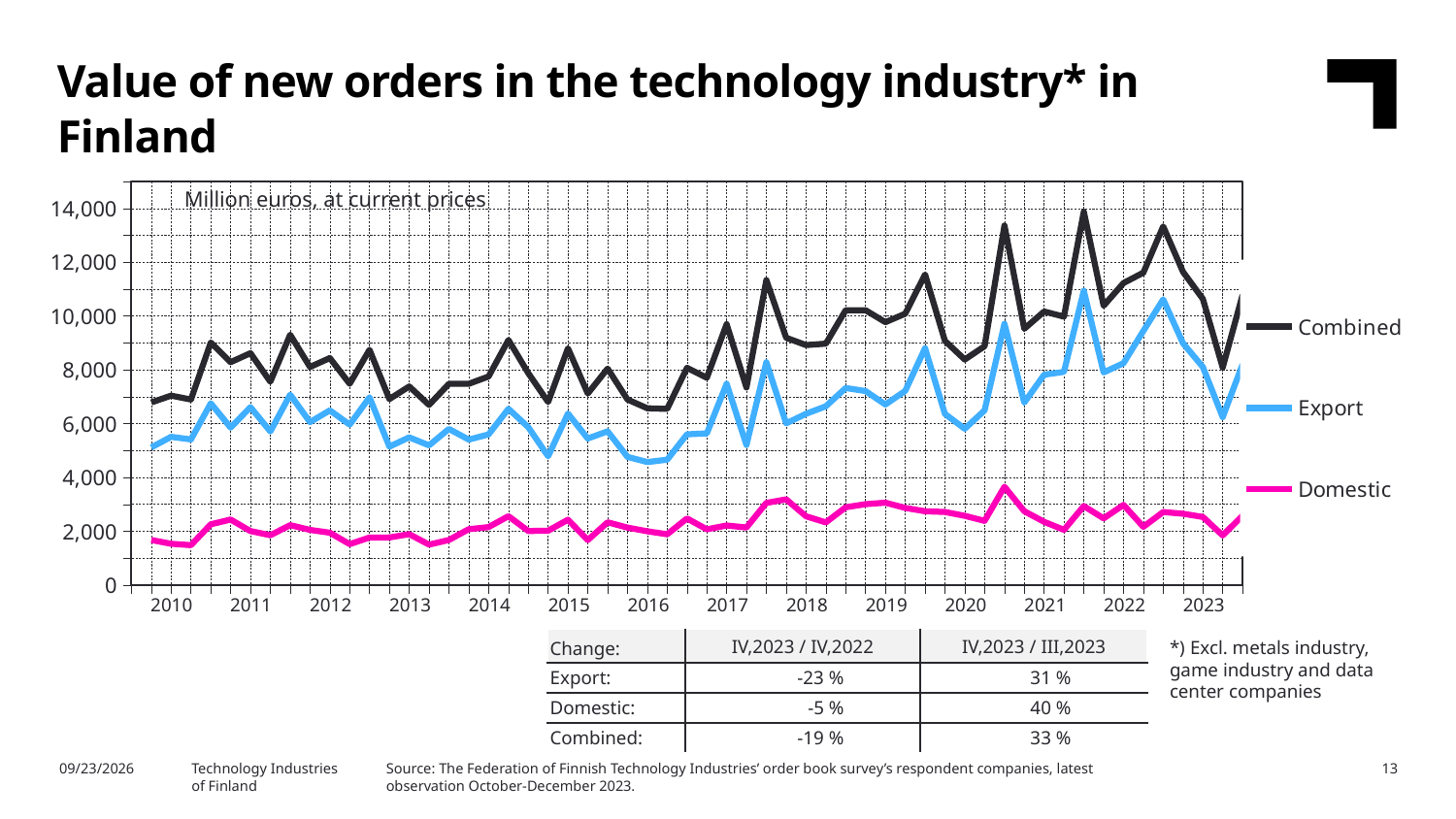
Which series has the highest values throughout the chart? Combined What type of chart is shown on the slide? line chart What are the three series named in the chart legend? Combined, Export, Domestic Overall, does the Combined series rise or fall from 2010 to 2023? rise Is the Domestic series ever greater or less than 4,000 million euros over the whole period? less Which is larger at the end of 2023, the Export series or the Domestic series? Export How many years are labelled on the x axis of the chart? 14 Is the peak of the Export series in 2021 greater or less than 10,000? greater How many series does the chart's legend list? 3 Which series has the lowest values throughout the chart? Domestic What unit is stated at the top of the chart area? Million euros, at current prices Is the value of the Combined series at the start of 2010 greater or less than 8,000? less